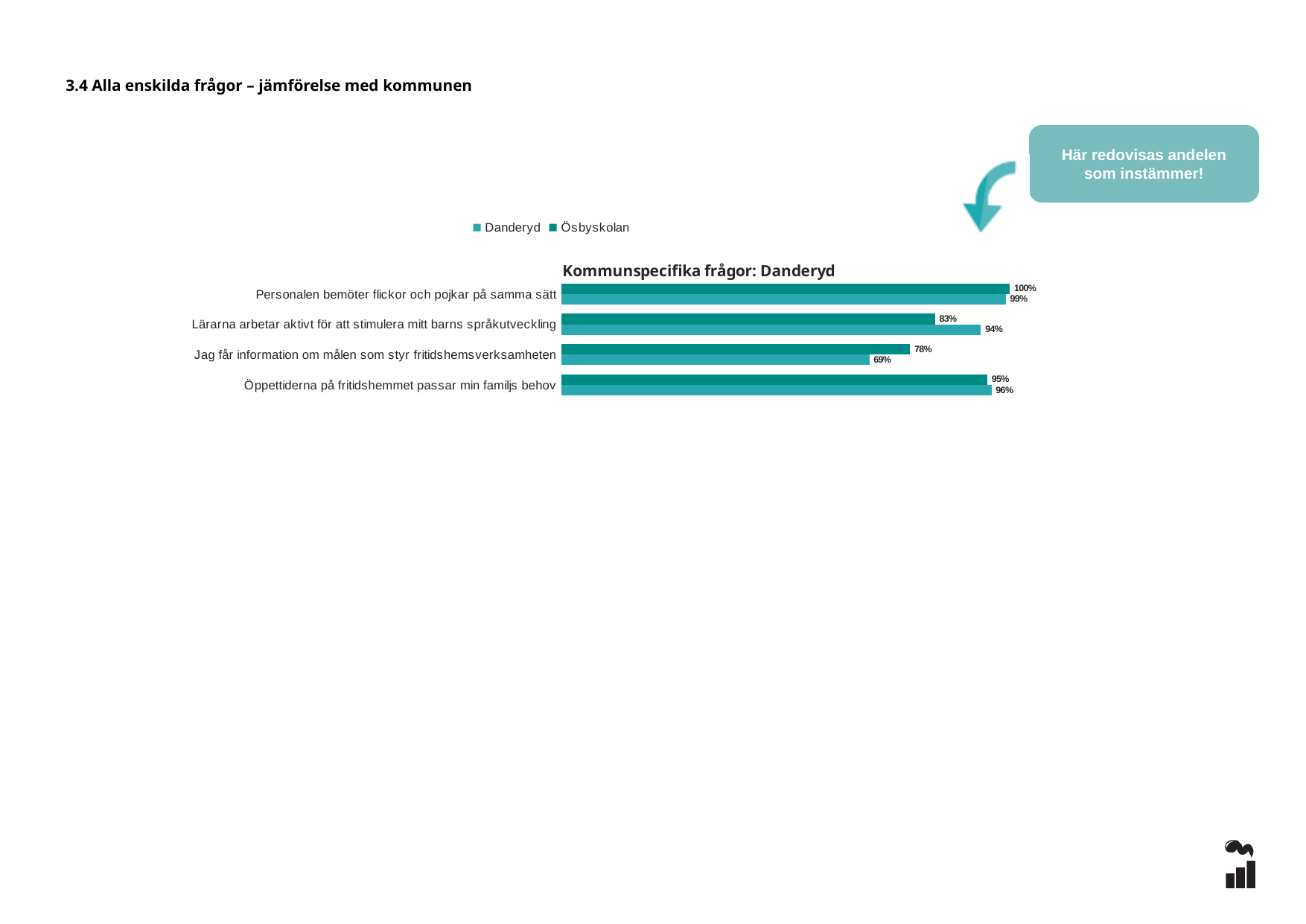
What is the title of the chart? Kommunspecifika frågor: Danderyd What is the Ösbyskolan value for 'Jag får information om målen som styr fritidshemsverksamheten'? 78% For 'Jag får information om målen som styr fritidshemsverksamheten', which is larger: the Danderyd value or the Ösbyskolan value? Ösbyskolan What is the difference between the Danderyd and Ösbyskolan values for 'Lärarna arbetar aktivt för att stimulera mitt barns språkutveckling'? 11% What is the Danderyd value for 'Lärarna arbetar aktivt för att stimulera mitt barns språkutveckling'? 94% What is the Danderyd value for 'Öppettiderna på fritidshemmet passar min familjs behov'? 96% What kind of chart is shown on the slide? bar chart Which category has the highest Ösbyskolan value? Personalen bemöter flickor och pojkar på samma sätt How many series does the legend list? 2 Which category has the lowest Danderyd value? Jag får information om målen som styr fritidshemsverksamheten How many categories (questions) are plotted in the chart? 4 What is the difference between the Ösbyskolan and Danderyd values for 'Jag får information om målen som styr fritidshemsverksamheten'? 9%